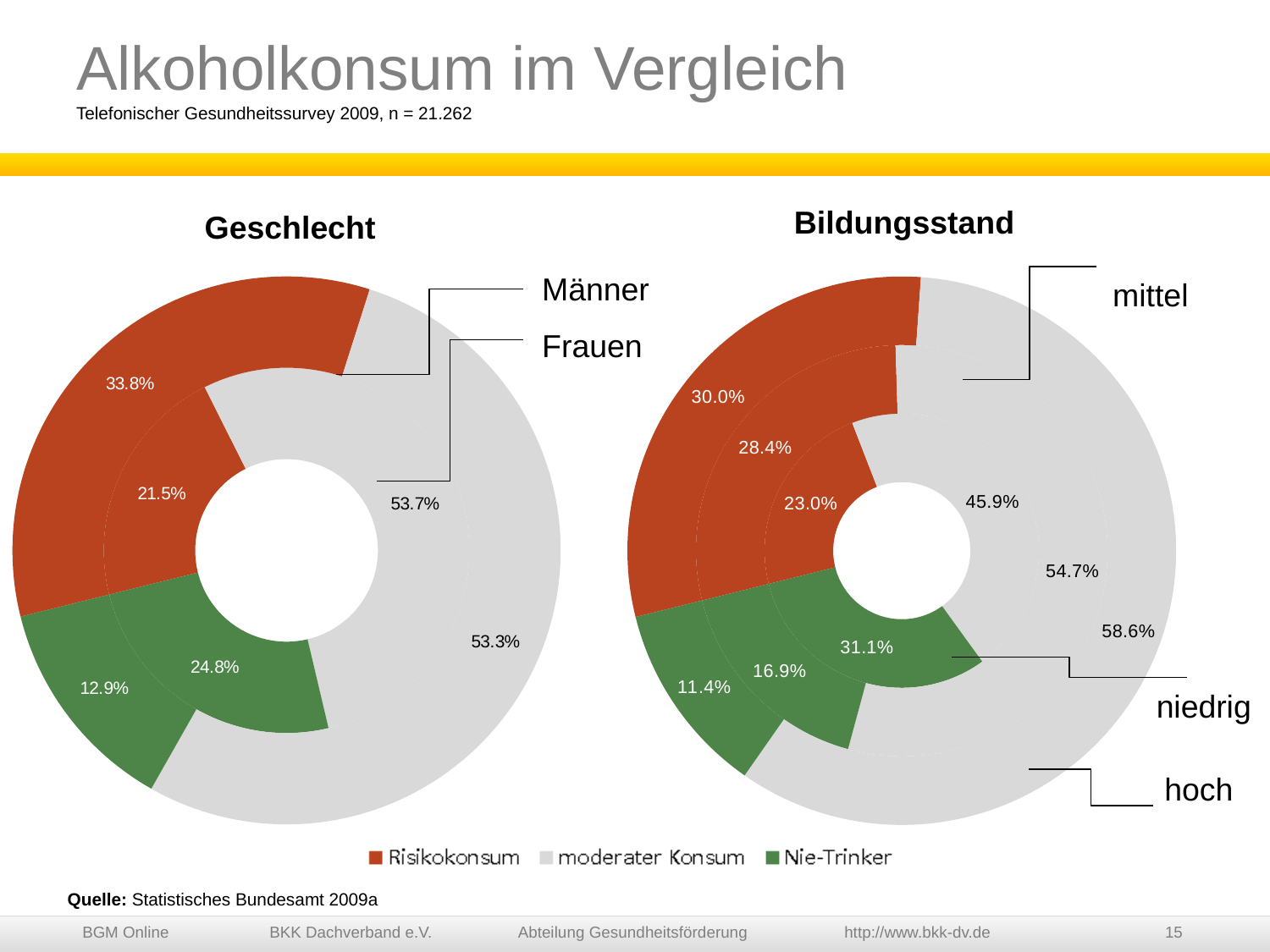
In the Bildungsstand chart, what is the Nie-Trinker share for the niedrig group? 31.1% What kind of chart is the Geschlecht chart? doughnut chart In the Geschlecht chart, what is the moderater Konsum share for Frauen? 53.7% How many series does the legend list? 3 What is the title of the chart on the left of the slide? Geschlecht In the Geschlecht chart, what is the Risikokonsum share for Männer? 33.8% In the Geschlecht chart, what is the Nie-Trinker share for Frauen? 24.8% In the Geschlecht chart, which group has the larger Nie-Trinker share, Männer or Frauen? Frauen In the Bildungsstand chart, which education level has the highest Risikokonsum share? hoch In the Bildungsstand chart, what is the moderater Konsum share for the hoch group? 58.6% In the Geschlecht chart, how many percentage points higher is the Risikokonsum share for Männer than for Frauen? 12.3 percentage points How many rings (education levels) does the Bildungsstand chart show? 3